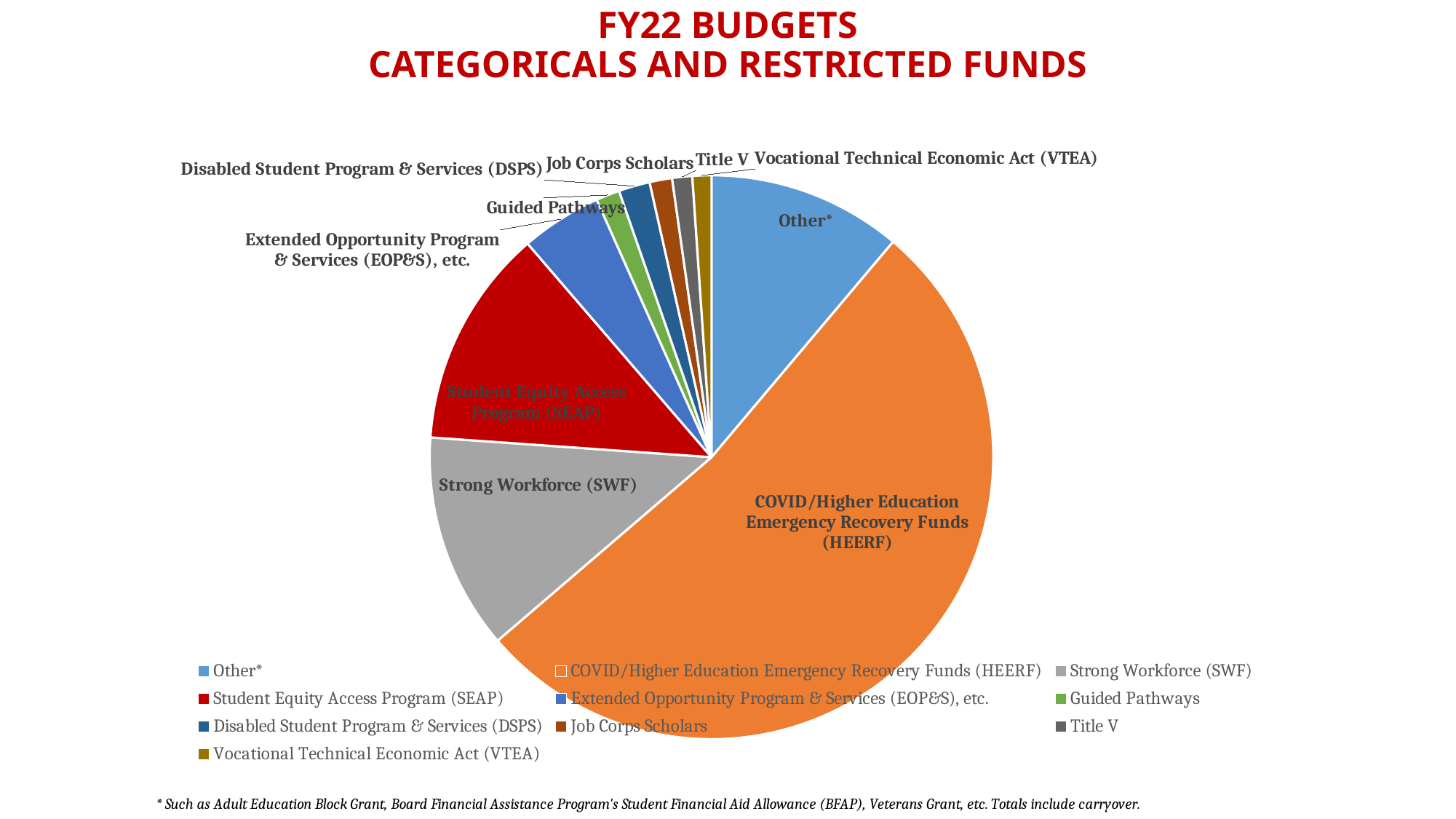
What is the title of the slide? FY22 BUDGETS CATEGORICALS AND RESTRICTED FUNDS Which slice is larger, Extended Opportunity Program & Services (EOP&S), etc. or Guided Pathways? Extended Opportunity Program & Services (EOP&S), etc. Which slice is larger, COVID/Higher Education Emergency Recovery Funds (HEERF) or Strong Workforce (SWF)? COVID/Higher Education Emergency Recovery Funds (HEERF) How many entries does the legend list? 10 Which slice is larger, Strong Workforce (SWF) or Title V? Strong Workforce (SWF) What colour is the COVID/Higher Education Emergency Recovery Funds (HEERF) slice? orange What kind of chart is shown on the slide? pie chart Which category has the largest slice of the pie? COVID/Higher Education Emergency Recovery Funds (HEERF) How many slices does the pie chart have? 10